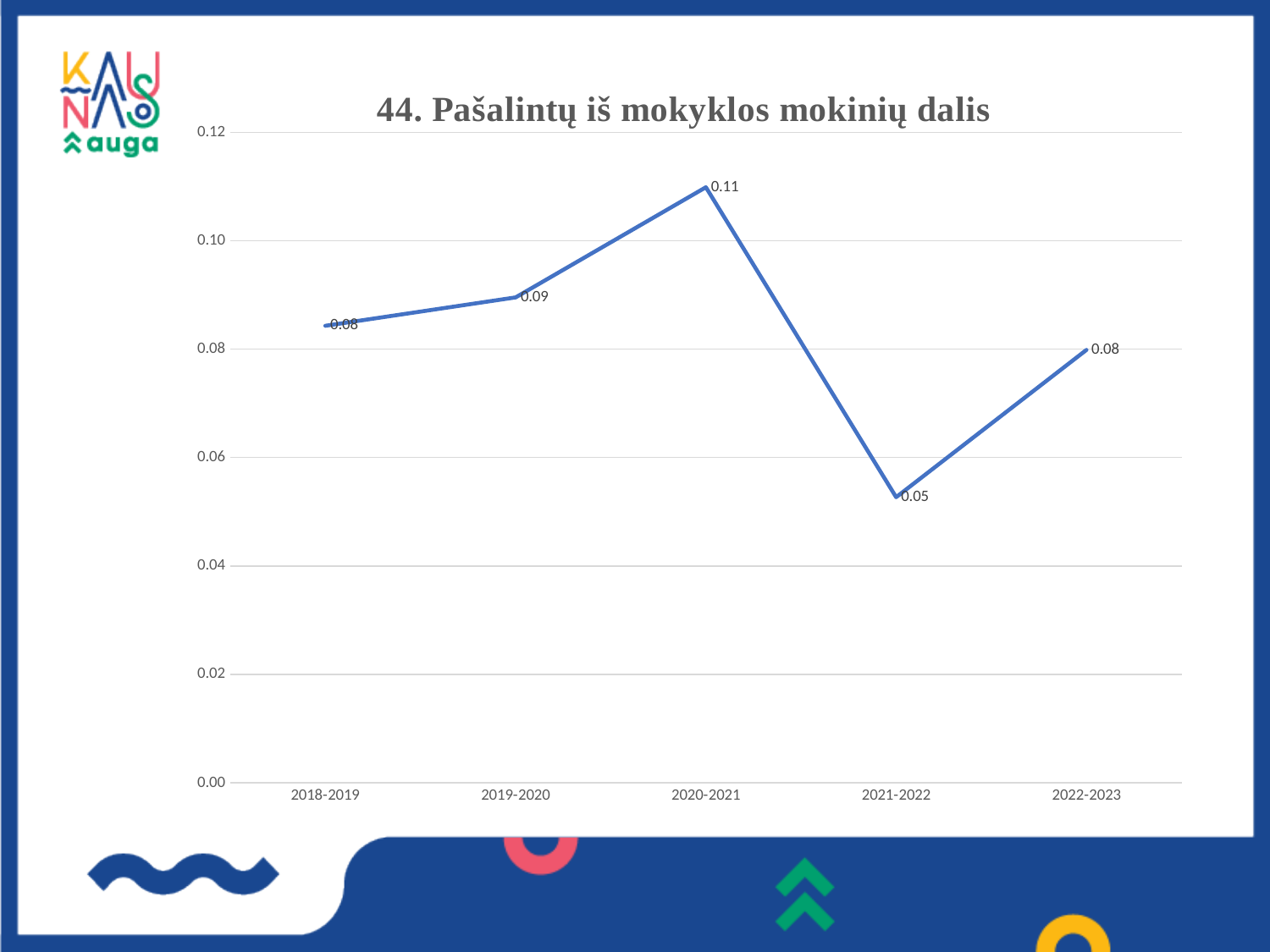
What is the value for 2020-2021? 0.11 Which school year has the highest value? 2020-2021 What is the value for 2022-2023? 0.08 What is the difference between the values for 2020-2021 and 2021-2022? 0.06 Which is larger, the value for 2019-2020 or the value for 2022-2023? 2019-2020 What is the title of the chart? 44. Pašalintų iš mokyklos mokinių dalis What is the value for 2019-2020? 0.09 Is the value for 2020-2021 greater or less than 0.10? greater What is the value for 2021-2022? 0.05 What kind of chart is shown on the slide? line chart Which school year has the lowest value? 2021-2022 How many school years are plotted on the chart? 5